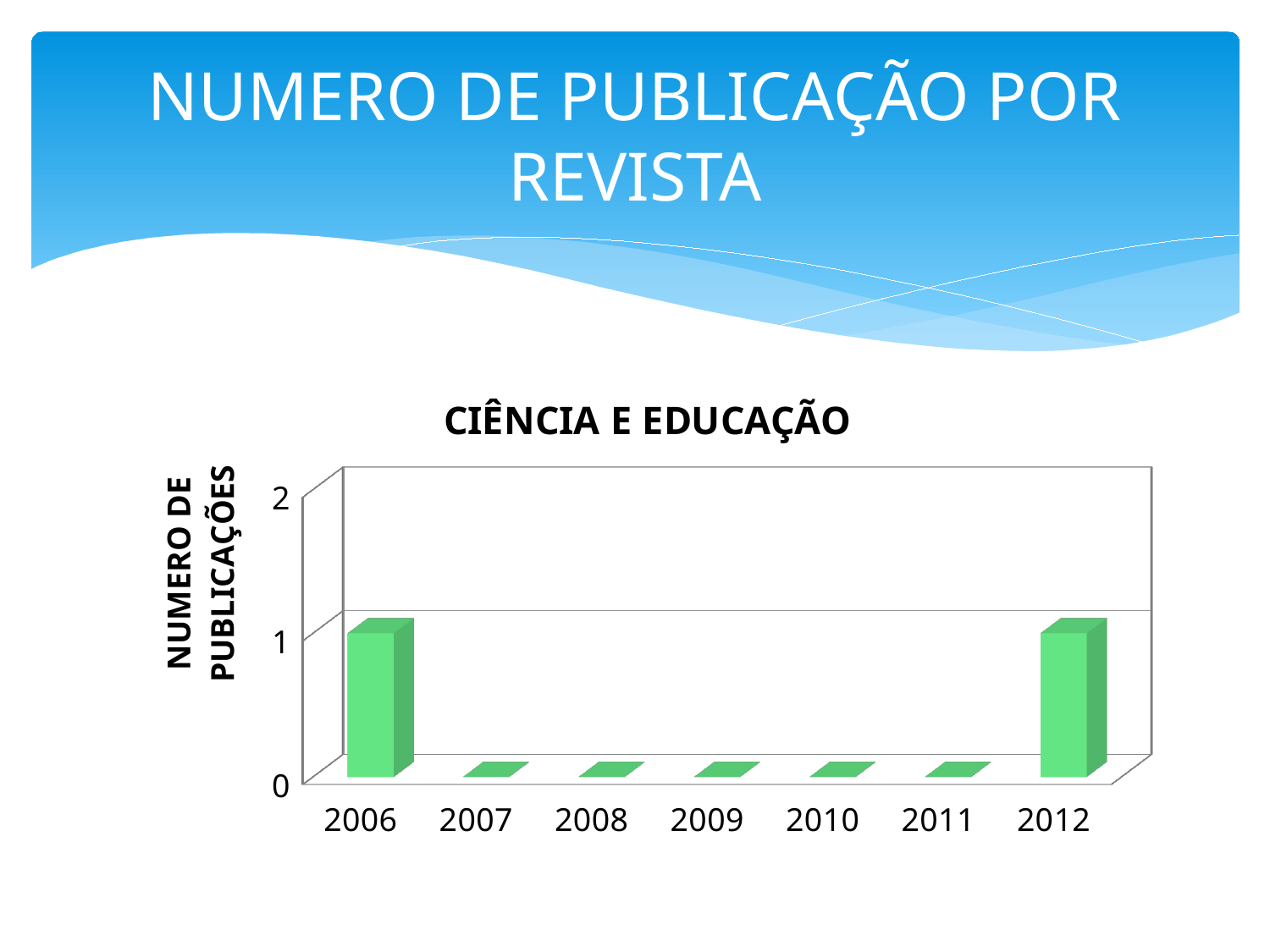
Is the value for 2006 greater or less than 2? less What is the number of publications for 2006? 1 Which is larger, the value for 2012 or the value for 2011? 2012 What is the label of the vertical axis? NUMERO DE PUBLICAÇÕES What is the difference between the values for 2006 and 2010? 1 What kind of chart is shown on the slide? bar chart What is the title of the chart? CIÊNCIA E EDUCAÇÃO What is the number of publications for 2007? 0 What is the number of publications for 2012? 1 What is the number of publications for 2009? 0 What is the highest value shown on the vertical axis? 2 How many years are shown on the x axis of the chart? 7